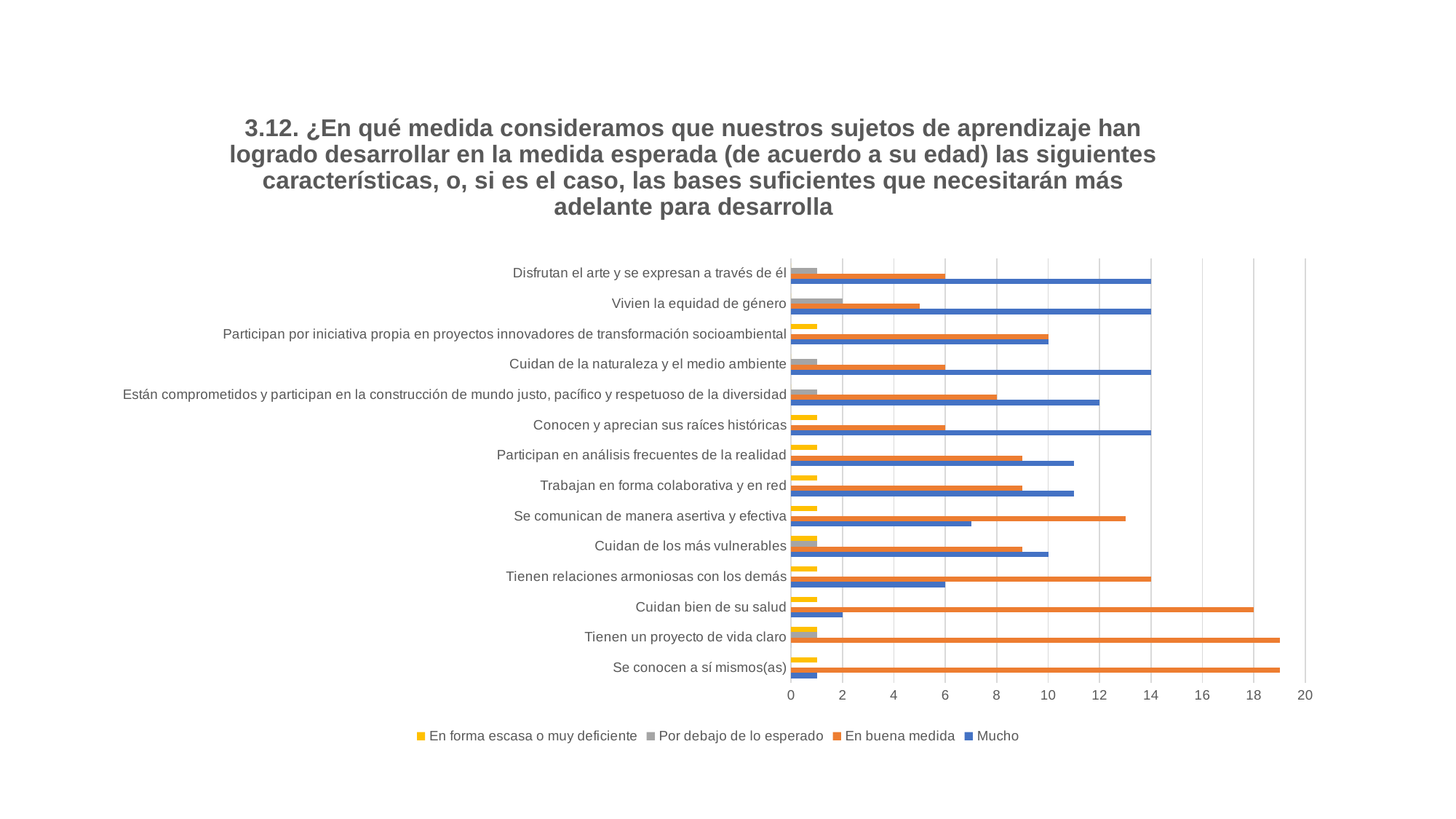
What is the value of 'Mucho' for 'Disfrutan el arte y se expresan a través de él'? 14 What kind of chart is shown on the slide? bar chart What is the value of 'Mucho' for 'Están comprometidos y participan en la construcción de mundo justo, pacífico y respetuoso de la diversidad'? 12 What is the value of 'En buena medida' for 'Tienen relaciones armoniosas con los demás'? 14 How many series does the legend list? 4 Is the value of 'Mucho' for 'Trabajan en forma colaborativa y en red' greater or less than 12? less What is the difference between 'En buena medida' and 'Mucho' for 'Cuidan bien de su salud'? 16 Is the value of 'En buena medida' for 'Se comunican de manera asertiva y efectiva' greater or less than 12? greater How many categories are plotted on the chart? 14 For 'Cuidan bien de su salud', which is larger: 'En buena medida' or 'Mucho'? En buena medida Which legend entry is shown in orange? En buena medida What is the value of 'En buena medida' for 'Cuidan bien de su salud'? 18